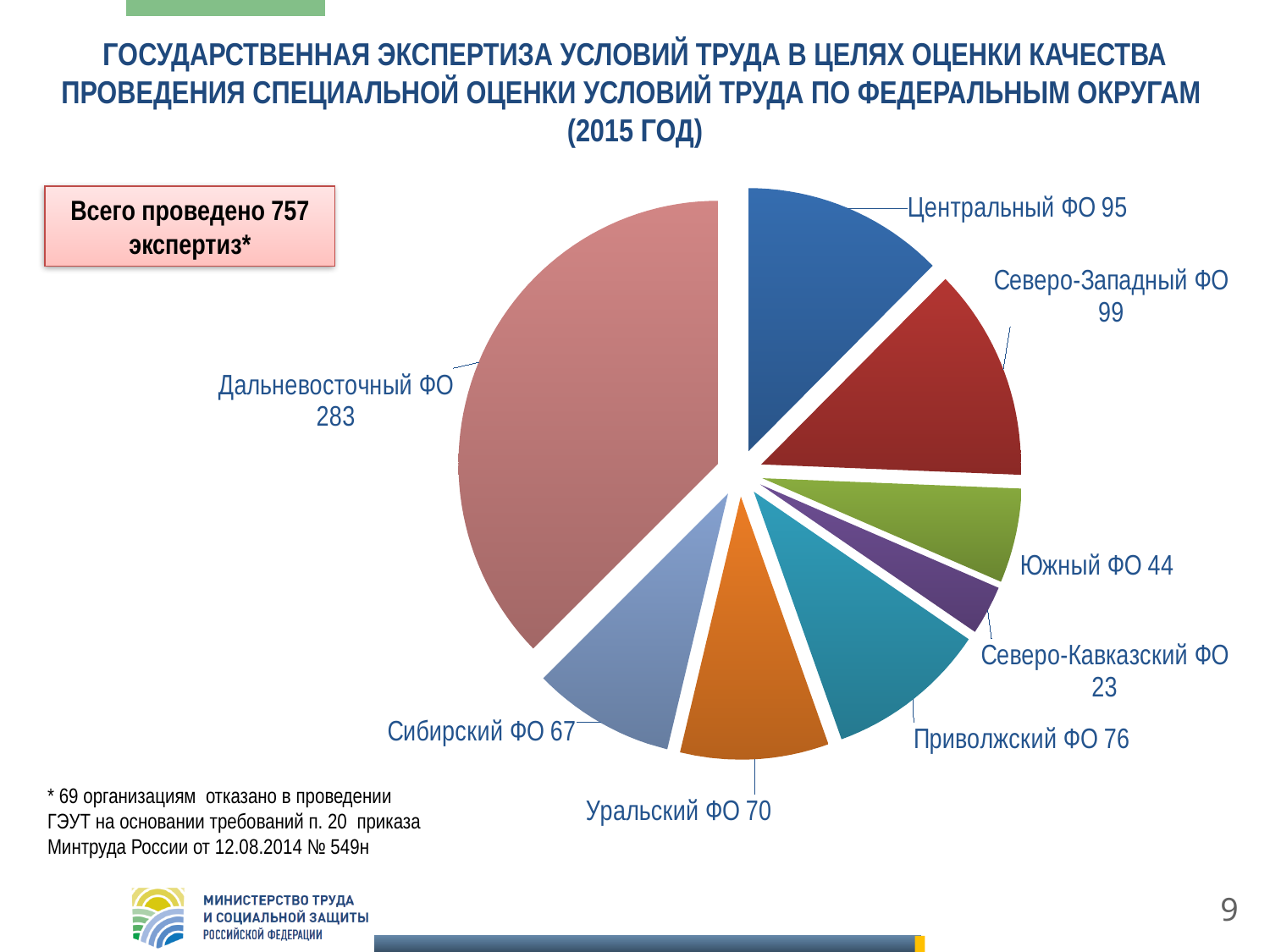
How many federal districts (slices) are shown in the pie chart? 8 What is the value for Уральский ФО? 70 What share of the total (757) does Дальневосточный ФО (283) represent? 37.4% What is the total number of expert reviews stated in the box on the slide? 757 Which is larger, the value for Северо-Западный ФО or Центральный ФО? Северо-Западный ФО What is the value for Северо-Кавказский ФО? 23 What is the difference between the values for Дальневосточный ФО and Северо-Западный ФО? 184 Which federal district has the largest slice? Дальневосточный ФО Which federal district has the smallest slice? Северо-Кавказский ФО What is the value for Дальневосточный ФО? 283 What kind of chart is shown on the slide? pie chart What is the difference between the values for Приволжский ФО and Сибирский ФО? 9